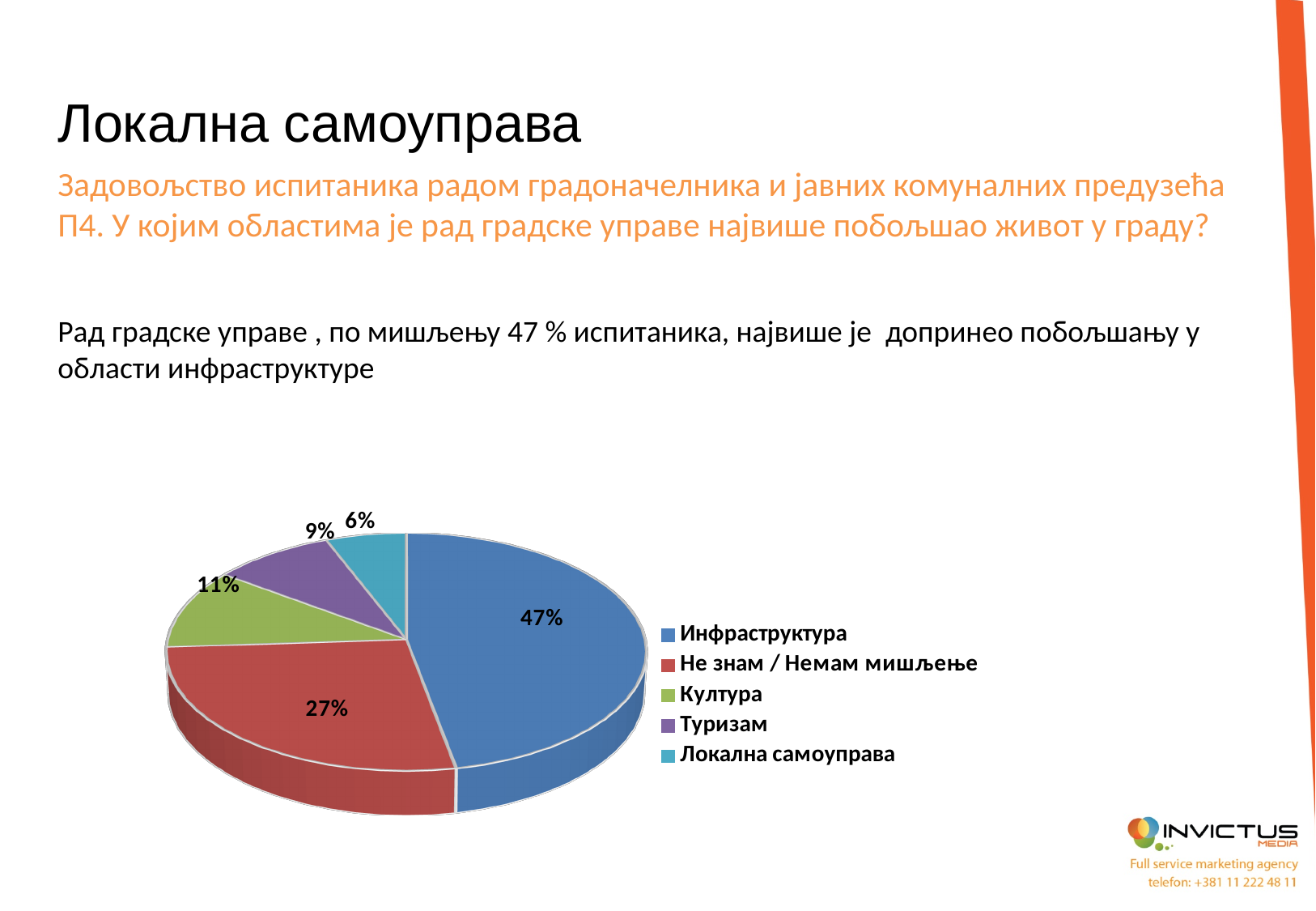
What kind of chart is shown on the slide? pie chart What is the difference between the values for Инфраструктура and Не знам / Немам мишљење? 20% Which category has the smallest slice of the pie? Локална самоуправа How many categories does the pie chart have? 5 Which category has the largest slice of the pie? Инфраструктура Which is larger, the value for Култура or the value for Туризам? Култура What is the value for Локална самоуправа? 6% What is the value for Култура? 11% What share of the pie does Инфраструктура have? 47% What is the value for Не знам / Немам мишљење? 27% What is the value for Туризам? 9% What colour is the slice for Туризам? purple